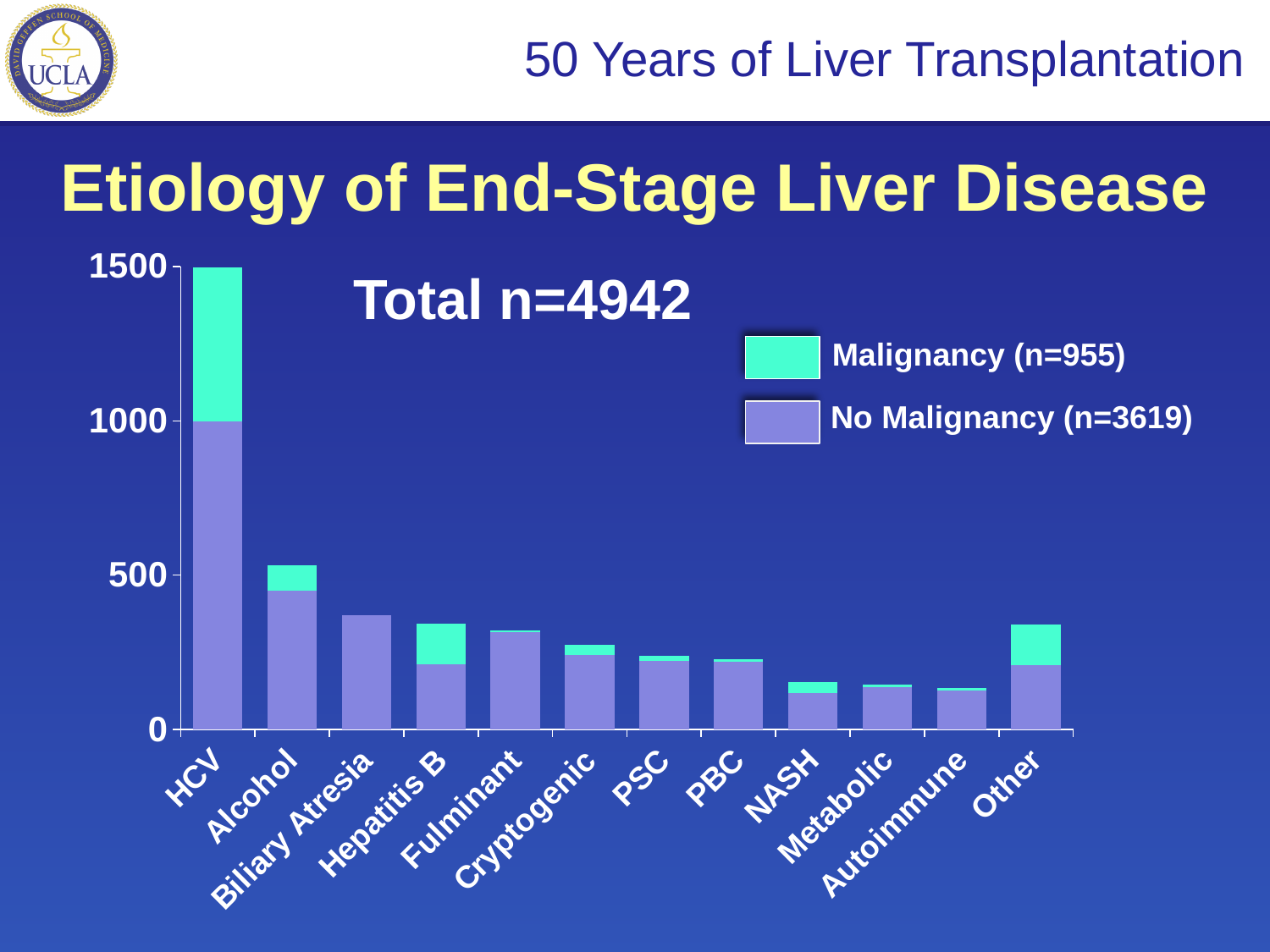
Which has a larger total bar, Alcohol or Hepatitis B? Alcohol Which has a larger total bar, NASH or Other? Other What kind of chart is shown on the slide? stacked bar chart Is the No Malignancy value for HCV greater or less than 500? greater What is the total n stated on the chart? Total n=4942 Which etiology has the highest total bar? HCV Which etiology has the lowest total bar? Autoimmune Is the total value for Alcohol greater or less than 500? greater What n value does the legend give for Malignancy? n=955 Is the total value for Biliary Atresia greater or less than 500? less How many etiology categories are shown along the x axis? 12 How many series does the legend list? 2